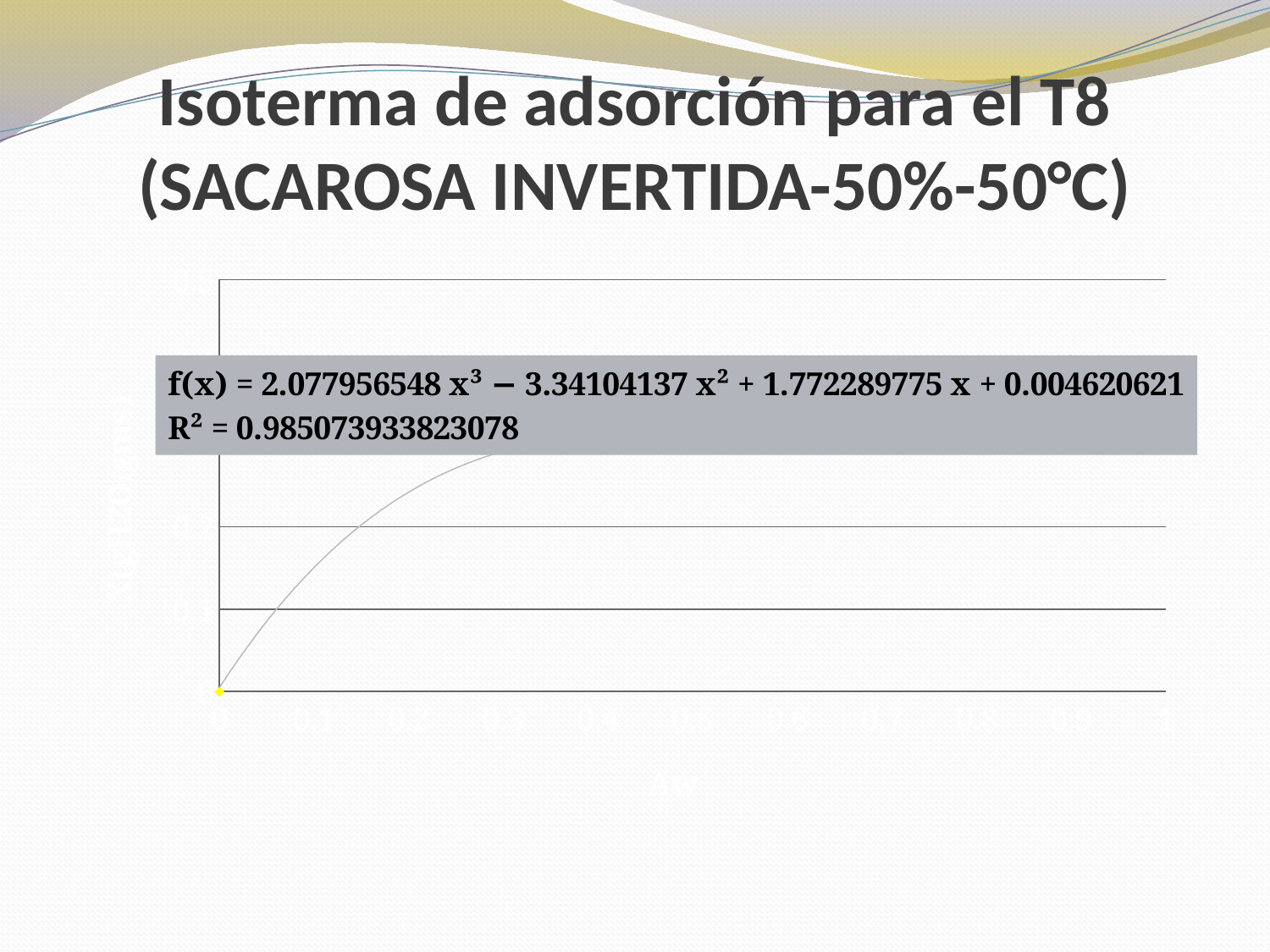
What is the R² value printed on the chart? 0.985073933823078 What is the title of the slide containing the chart? Isoterma de adsorción para el T8 (SACAROSA INVERTIDA-50%-50°C) Does the fitted curve rise or fall as Aw increases from 0 to 0.5? rises What is the coefficient of x³ in the trendline equation f(x) shown on the chart? 2.077956548 Is the value of the fitted curve at Aw = 0.3 greater or less than 0.4? less Is the value of the fitted curve at Aw = 0.2 greater or less than 0.1? greater Is the value of the fitted curve at Aw = 0.5 greater or less than 0.2? greater What is the constant term in the trendline equation f(x) shown on the chart? 0.004620621 What is the highest value labelled on the x axis (Aw)? 1